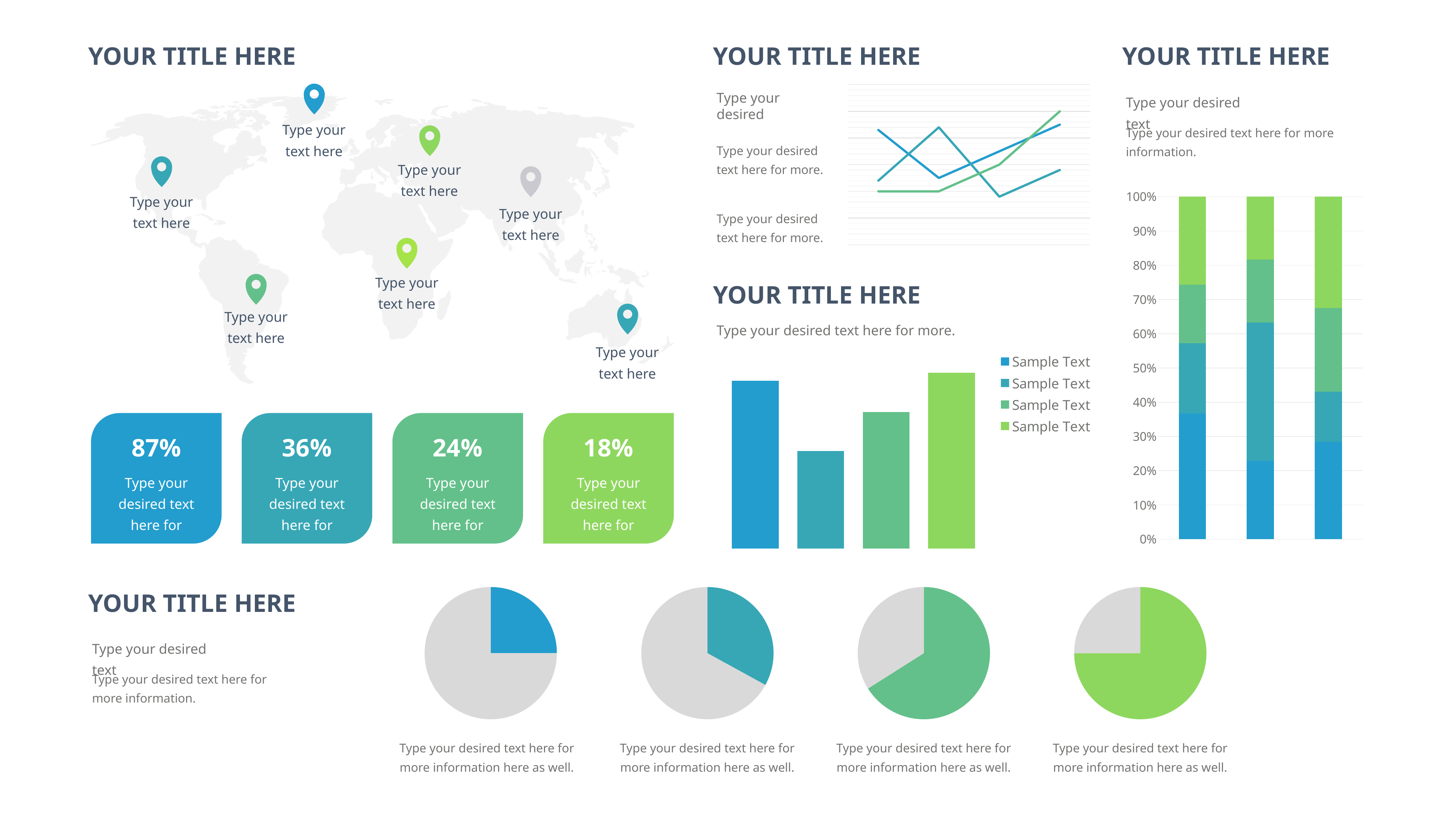
In the bar chart in the middle of the slide, which bar is the tallest? the green (rightmost) bar What kind of chart is shown in the middle of the slide with the four 'Sample Text' legend entries? bar chart How many bars are plotted in the stacked bar chart on the right side of the slide? 3 What kind of chart is shown on the right side of the slide with the 0% to 100% axis? stacked bar chart How many entries does the legend of the bar chart in the middle of the slide list? 4 How many pie charts are shown along the bottom of the slide? 4 How many bars are plotted in the bar chart in the middle of the slide with the 'Sample Text' legend? 4 What kind of chart is shown at the top middle of the slide, to the right of the 'Type your desired text here for more.' text? line chart In the bar chart in the middle of the slide, which is taller: the blue (first) bar or the green (third) bar? the blue (first) bar In the stacked bar chart on the right side of the slide, is the value for the blue segment of the leftmost bar greater or less than 30%? greater In the bar chart in the middle of the slide, which bar is the shortest? the teal (second) bar